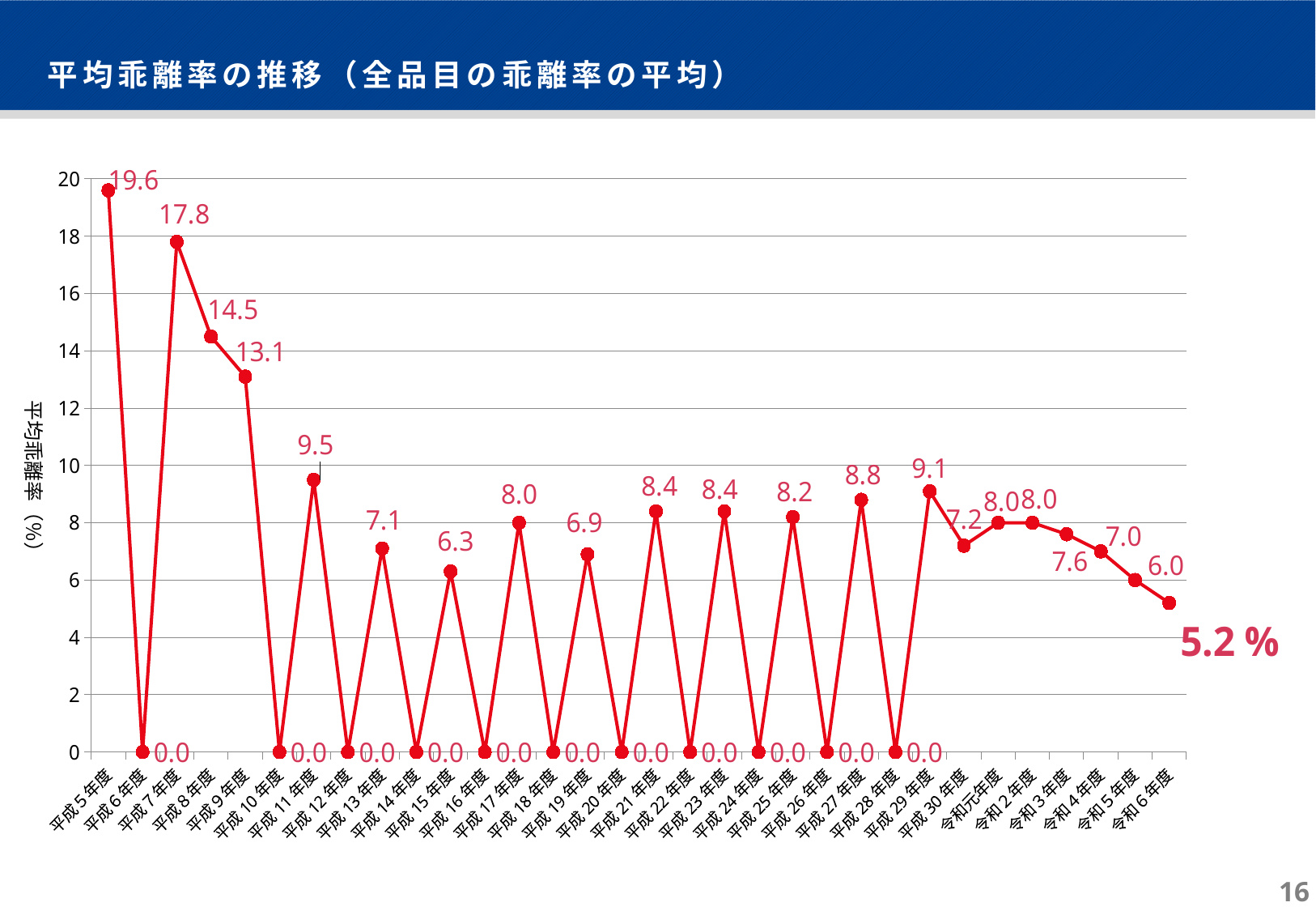
Is the value for 平成8年度 greater or less than 14? greater What is the value for 令和6年度? 5.2 % How many fiscal years are plotted on the x axis? 32 Which fiscal year has the highest value? 平成5年度 Which is larger, the value for 平成27年度 or the value for 平成25年度? 平成27年度 What is the value for 平成5年度? 19.6 What is the value for 平成30年度? 7.2 What is the value for 平成29年度? 9.1 What is the difference between the values for 令和5年度 and 令和6年度? 0.8 What kind of chart is shown on the slide? line chart Do the values rise or fall from 令和2年度 to 令和6年度? fall What is the difference between the values for 平成5年度 and 平成7年度? 1.8